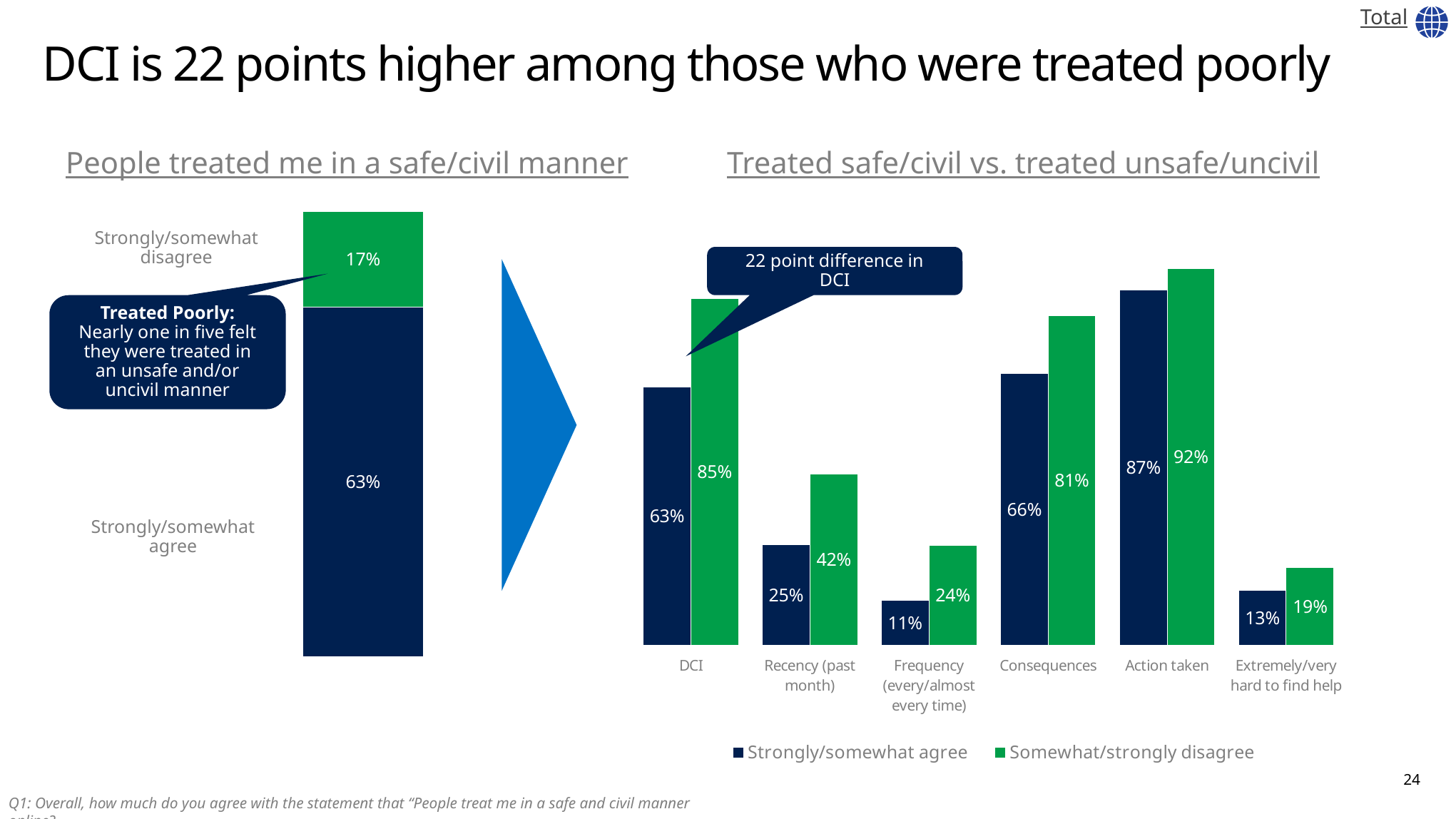
What kind of chart is the 'People treated me in a safe/civil manner' chart? Stacked bar chart In the 'Treated safe/civil vs. treated unsafe/uncivil' chart, what is the value for Frequency (every/almost every time) among those who strongly/somewhat agree? 11% In the 'Treated safe/civil vs. treated unsafe/uncivil' chart, what is the value for DCI among those who strongly/somewhat agree? 63% How many categories are shown on the x axis of the 'Treated safe/civil vs. treated unsafe/uncivil' chart? 6 In the 'Treated safe/civil vs. treated unsafe/uncivil' chart, what is the value for Action taken among those who somewhat/strongly disagree? 92% In the 'Treated safe/civil vs. treated unsafe/uncivil' chart, which is larger for Consequences: the strongly/somewhat agree value or the somewhat/strongly disagree value? Somewhat/strongly disagree How many series does the legend of the 'Treated safe/civil vs. treated unsafe/uncivil' chart list? 2 In the 'Treated safe/civil vs. treated unsafe/uncivil' chart, which category has the lowest value for the strongly/somewhat agree series? Frequency (every/almost every time) In the 'Treated safe/civil vs. treated unsafe/uncivil' chart, what is the difference between the somewhat/strongly disagree and strongly/somewhat agree values for Recency (past month)? 17% In the 'Treated safe/civil vs. treated unsafe/uncivil' chart, which category has the highest value for the somewhat/strongly disagree series? Action taken In the 'People treated me in a safe/civil manner' chart, what is the total of the stacked bar? 80% In the 'People treated me in a safe/civil manner' chart, what is the value for Strongly/somewhat disagree? 17%